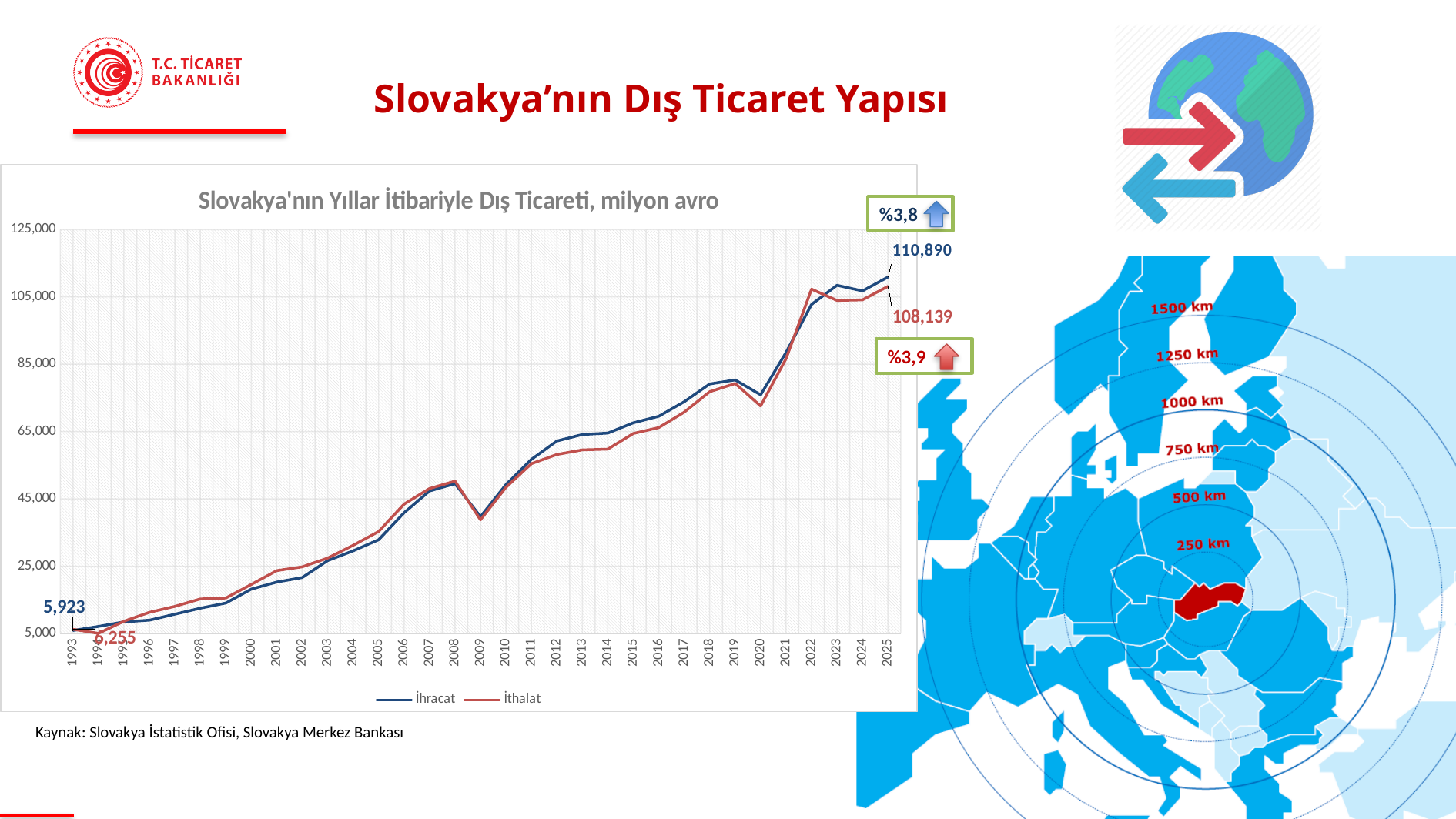
What is the difference between İhracat and İthalat in 2025? 2,751 What type of chart is shown on the slide? line chart Which series has the larger value in 1993, İhracat or İthalat? İthalat Which series has the larger value in 2025, İhracat or İthalat? İhracat Overall, do the İhracat values rise or fall from 1993 to 2025? rise What is the value of İthalat in 2025? 108,139 What is the value of İhracat in 1993? 5,923 What is the value of İhracat in 2025? 110,890 What is the title of the chart? Slovakya'nın Yıllar İtibariyle Dış Ticareti, milyon avro Is the value of İhracat in 2009 greater or less than 45,000? less What is the value of İthalat in 1993? 6,255 How many series does the chart legend list? 2